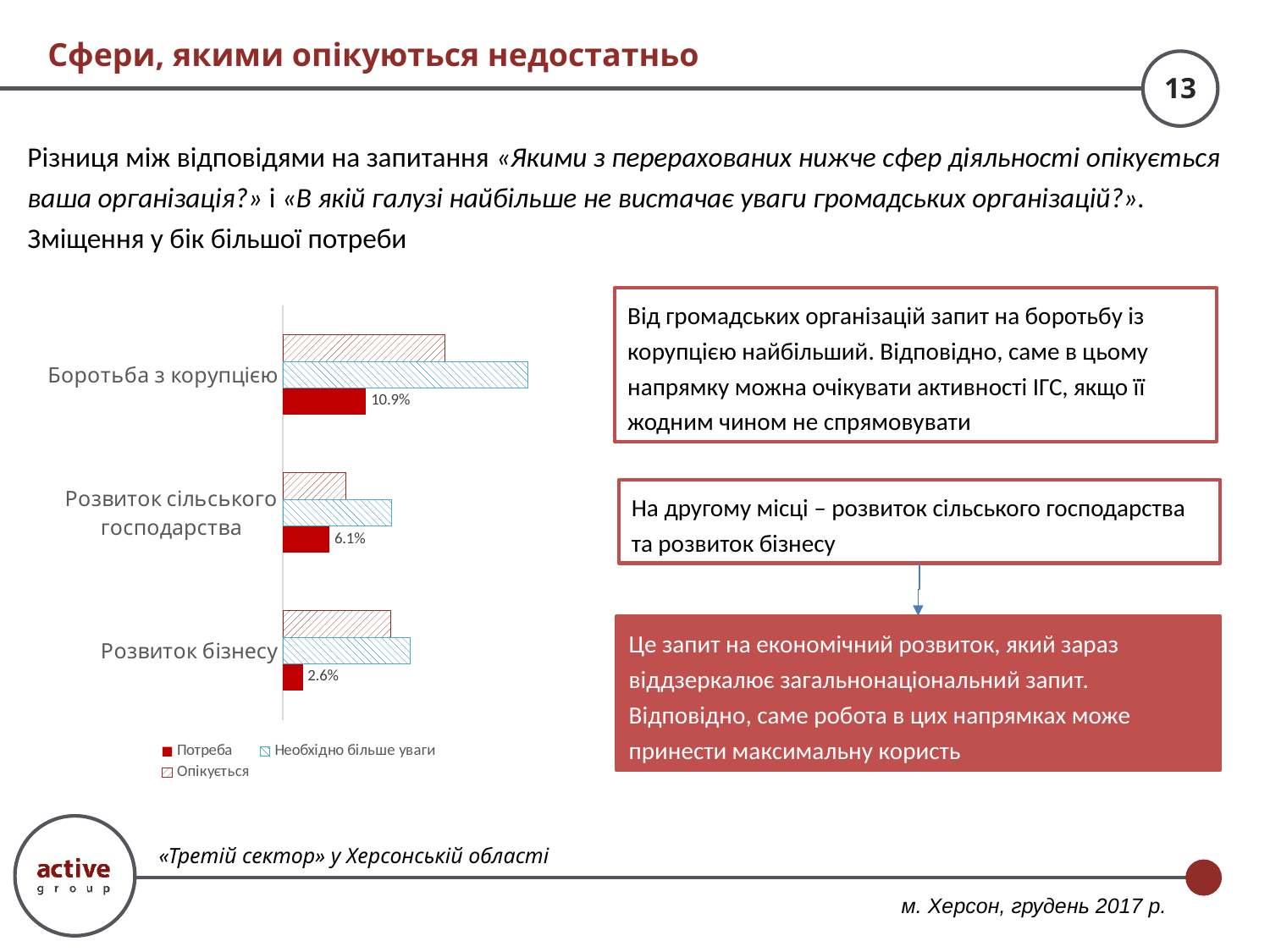
What is the difference between the Потреба values for Розвиток сільського господарства and Розвиток бізнесу? 3.5% What is the value of the Потреба series for Розвиток бізнесу? 2.6% How many categories are shown on the chart? 3 Which category has the highest Потреба value? Боротьба з корупцією How many series does the chart legend list? 3 What is the difference between the Потреба values for Боротьба з корупцією and Розвиток сільського господарства? 4.8% Which series in the legend is drawn as a solid red bar? Потреба What is the value of the Потреба series for Боротьба з корупцією? 10.9% For Боротьба з корупцією, which series has the longer bar: Необхідно більше уваги or Опікується? Необхідно більше уваги What type of chart is shown on the slide? Bar chart What is the value of the Потреба series for Розвиток сільського господарства? 6.1% Which category has the lowest Потреба value? Розвиток бізнесу